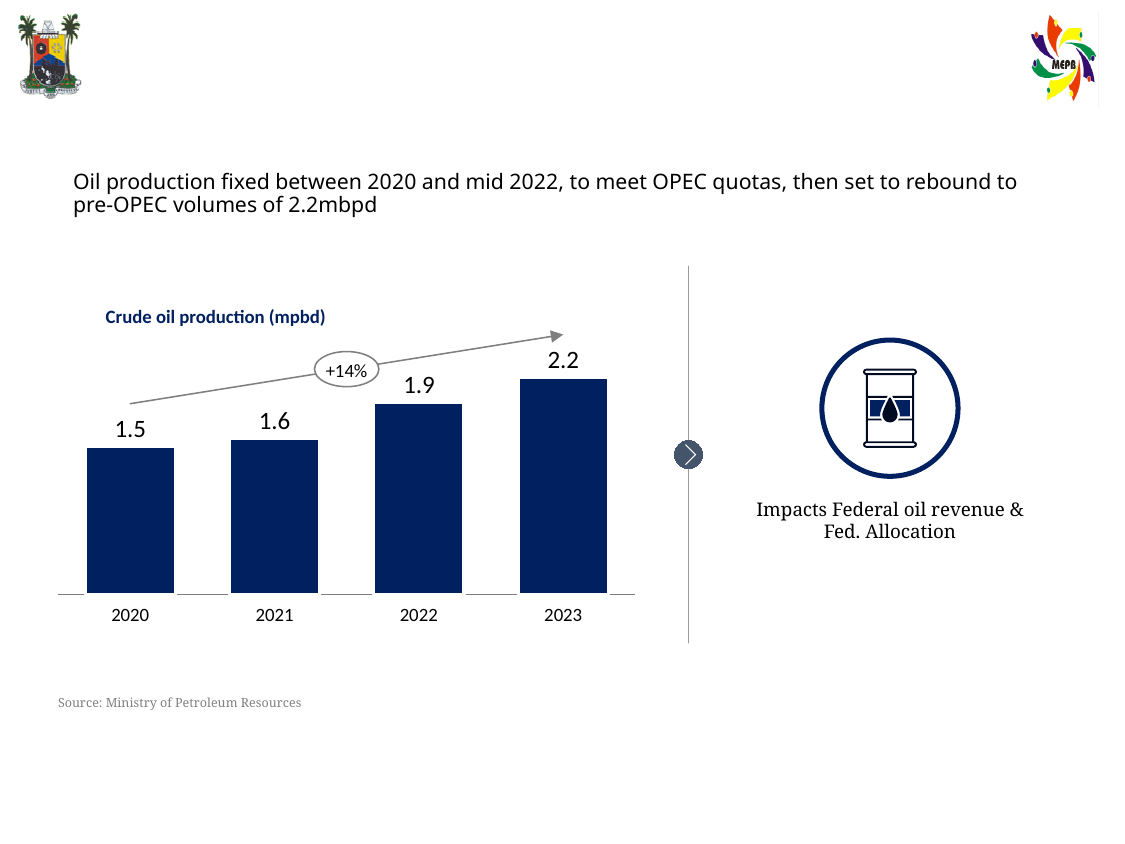
What is the crude oil production value for 2023? 2.2 How many years are shown on the chart? 4 Which year has the highest crude oil production? 2023 What is the difference in crude oil production between 2023 and 2020? 0.7 What is the title of the chart? Crude oil production (mpbd) What is the crude oil production value for 2022? 1.9 Which year has the lowest crude oil production? 2020 What is the crude oil production value for 2020? 1.5 Which year has higher crude oil production, 2021 or 2022? 2022 What is the difference in crude oil production between 2022 and 2021? 0.3 Do the crude oil production values rise or fall from 2020 to 2023? Rise What kind of chart is shown on the slide? Bar chart